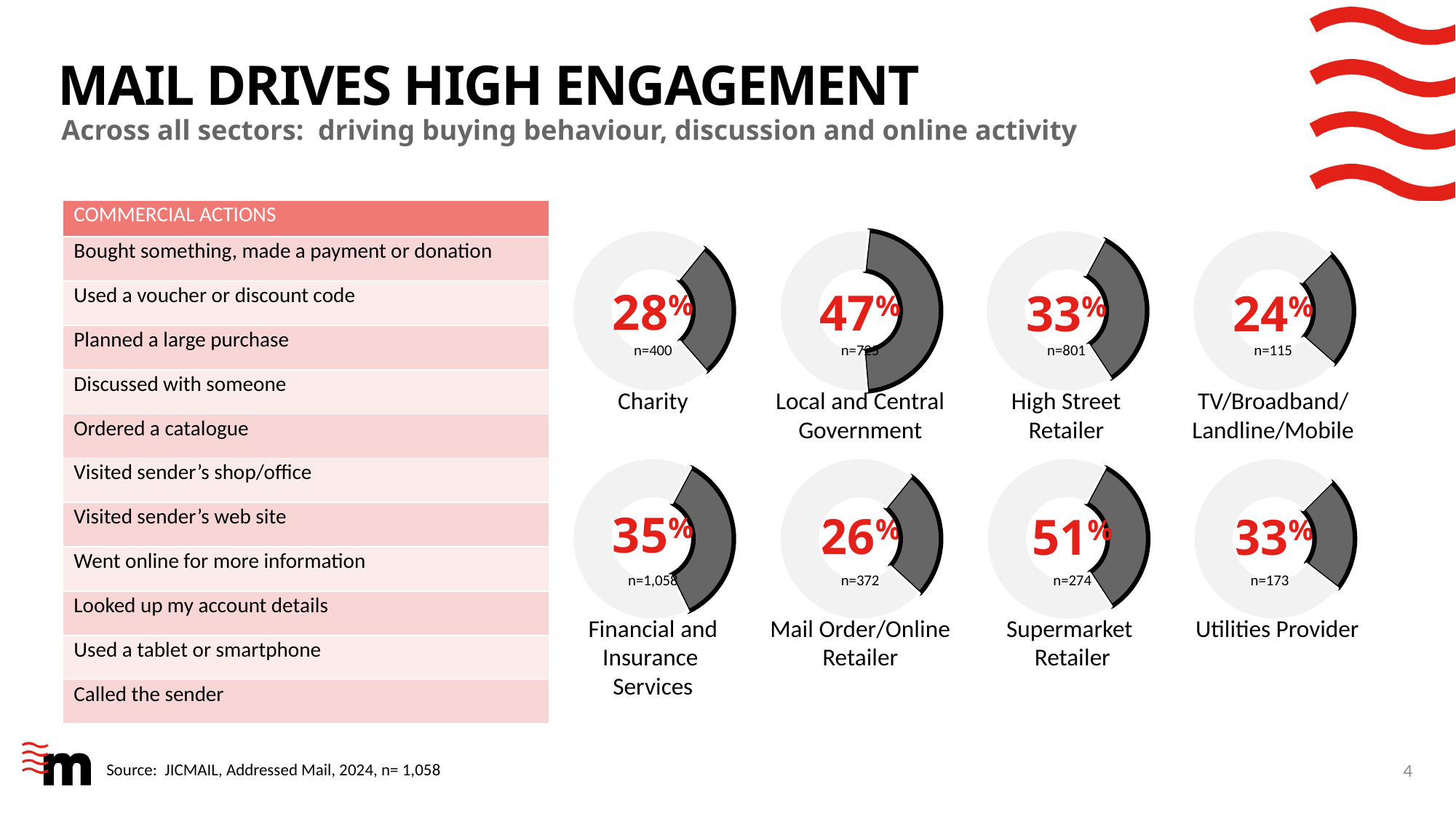
Which sector's donut chart shows the lowest percentage? TV/Broadband/Landline/Mobile What is the sample size (n) shown in the Financial and Insurance Services donut chart? n=1,058 Which is larger, the percentage for High Street Retailer or the percentage for Charity? High Street Retailer What percentage is shown in the Charity donut chart? 28% What is the difference between the Supermarket Retailer percentage and the Mail Order/Online Retailer percentage? 25% What percentage is shown in the TV/Broadband/Landline/Mobile donut chart? 24% How many donut charts are shown on the slide? 8 Which sector's donut chart shows the highest percentage? Supermarket Retailer What percentage is shown in the Local and Central Government donut chart? 47% What percentage is shown in the Supermarket Retailer donut chart? 51% What percentage is shown in the Financial and Insurance Services donut chart? 35% What kind of chart is used to show the percentage for each sector? Donut chart